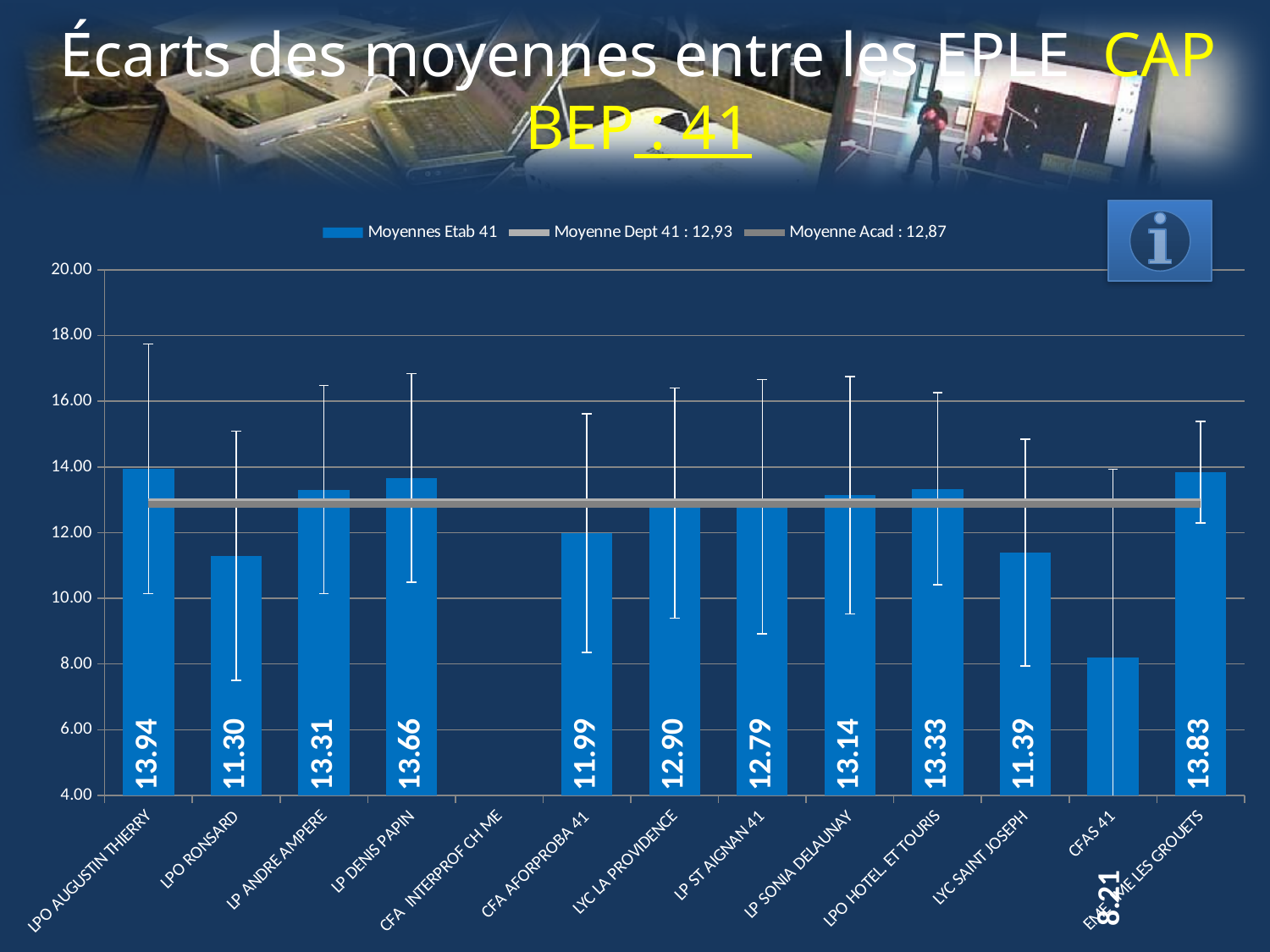
Which establishment has the highest value? LPO AUGUSTIN THIERRY Which establishment has the lowest value? CFAS 41 Is the value for CFAS 41 greater or less than 10.00? less What is the value for LPO RONSARD? 11.30 How many category labels are shown on the x axis? 13 What is the difference between the values for LPO AUGUSTIN THIERRY and LPO RONSARD? 2.64 What value does the legend give for Moyenne Dept 41? 12,93 What is the value for CFA AFORPROBA 41? 11.99 What kind of chart is shown on the slide? combination bar and line chart What is the value for LP DENIS PAPIN? 13.66 Which is larger, the value for LP SONIA DELAUNAY or the value for LYC SAINT JOSEPH? LP SONIA DELAUNAY How many series does the legend list? 3